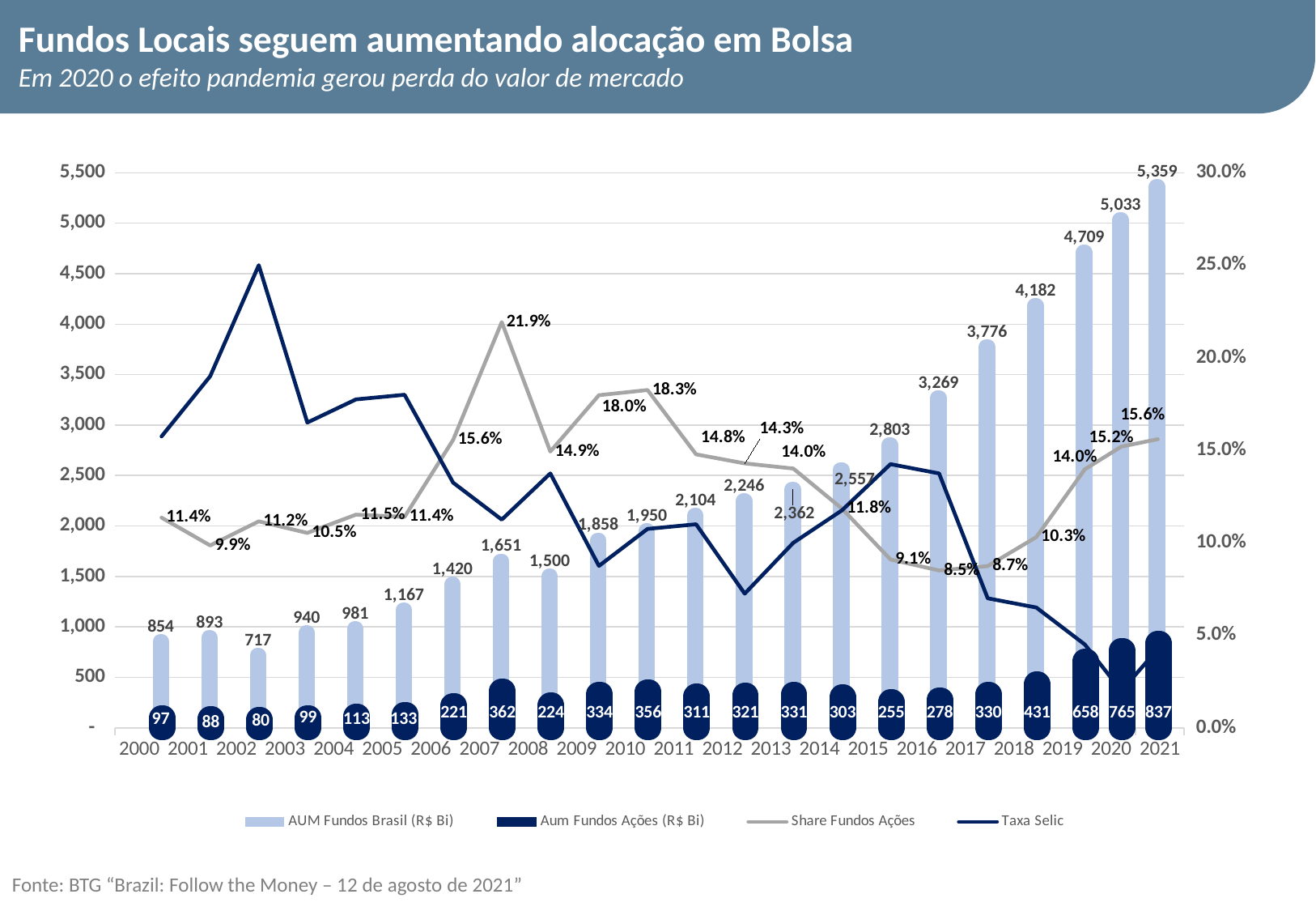
Is the Taxa Selic value for 2002 greater or less than 20.0%? greater What is the value of Aum Fundos Ações (R$ Bi) for 2007? 362 What is the Share Fundos Ações value for 2019? 14.0% How many series does the legend list? 4 What is the difference between AUM Fundos Brasil (R$ Bi) in 2021 and in 2020? 326 In which year is AUM Fundos Brasil (R$ Bi) lowest? 2002 How many years are shown on the x axis? 22 What kind of chart is shown on the slide? A combined bar and line chart In which year is the Share Fundos Ações highest? 2007 In which year is the Share Fundos Ações lowest? 2016 What is the value of AUM Fundos Brasil (R$ Bi) for 2021? 5,359 Which year has the larger Aum Fundos Ações (R$ Bi) value, 2009 or 2010? 2010